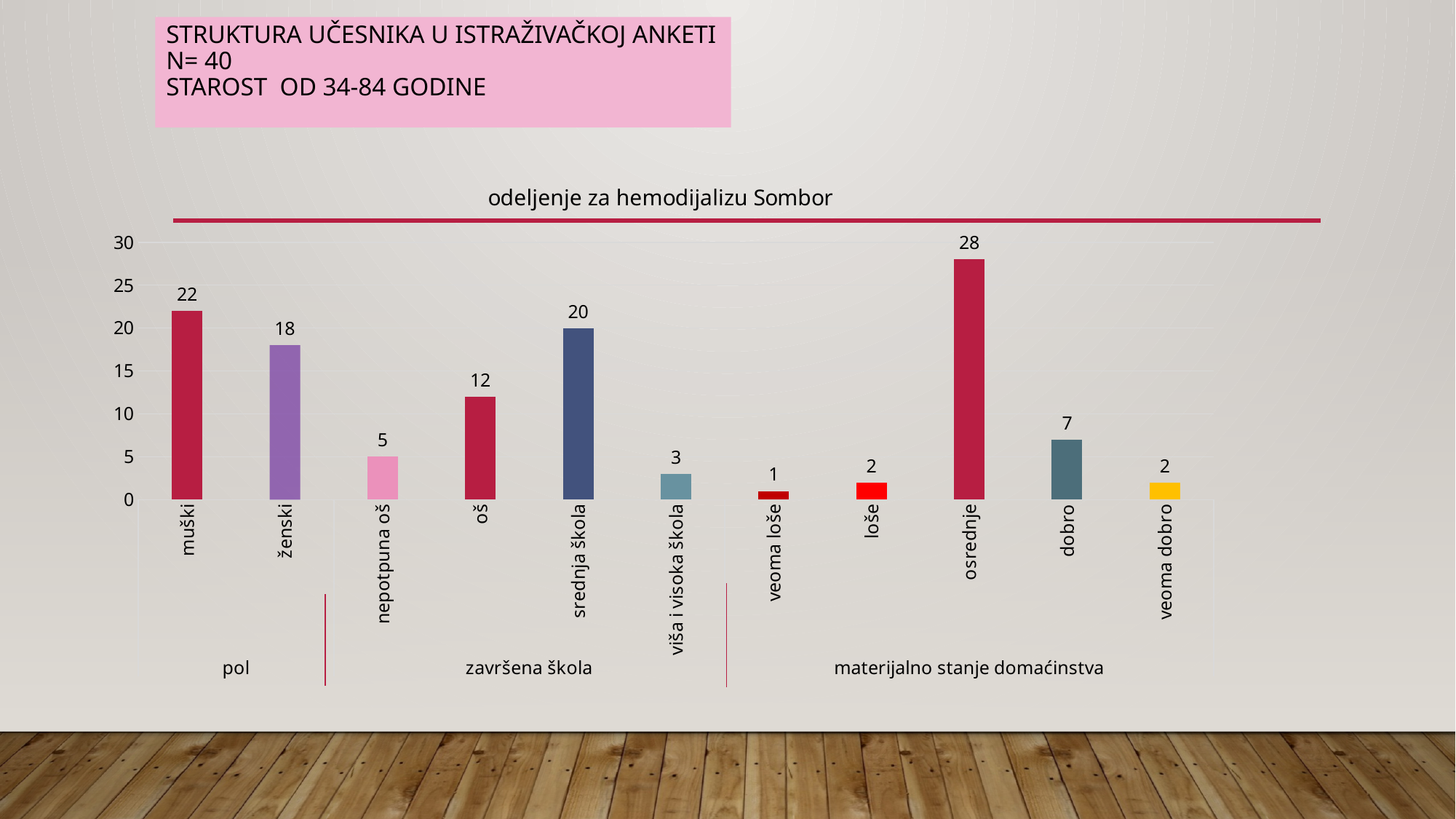
What is the difference between the values for muški and ženski? 4 What is the value for muški? 22 How many bars are plotted in the chart? 11 Which category has the lowest value? veoma loše Which is larger, the value for oš or the value for nepotpuna oš? oš What is the difference between the values for osrednje and dobro? 21 What is the value for srednja škola? 20 Which category has the highest value? osrednje What is the title of the chart? odeljenje za hemodijalizu Sombor Is the value for osrednje greater or less than 25? greater What kind of chart is shown? bar chart What is the value for veoma loše? 1